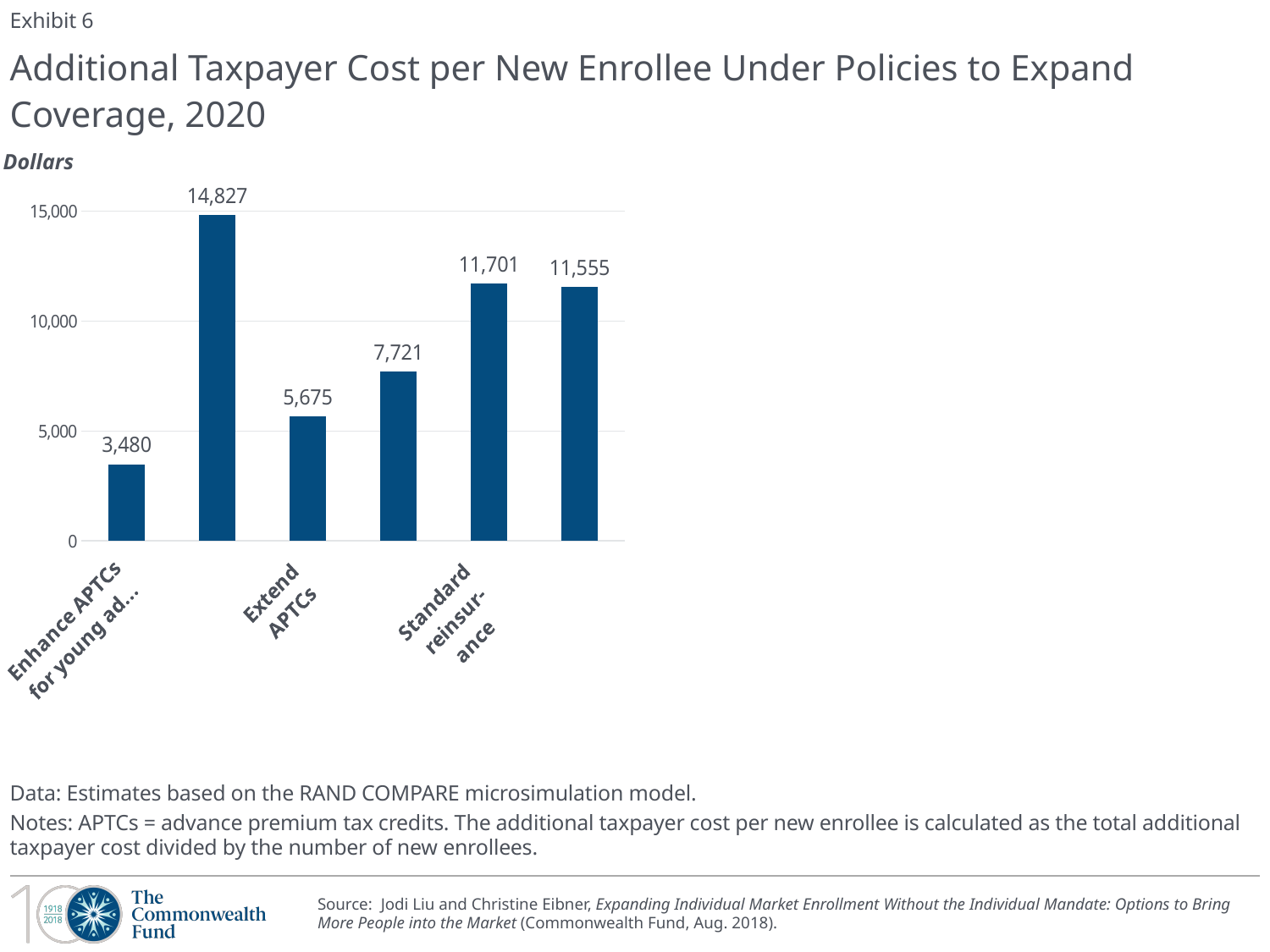
What is the additional taxpayer cost per new enrollee for Extend APTCs? 5,675 Is the value for Standard reinsurance greater or less than 10,000? greater How much larger is the value for Standard reinsurance than the value for Extend APTCs? 6,026 What is the lowest value shown on the chart? 3,480 What is the additional taxpayer cost per new enrollee for Standard reinsurance? 11,701 What kind of chart is shown on the slide? bar chart What unit is indicated for the values on the chart? Dollars What is the difference between the highest and lowest values on the chart? 11,347 Is the value for Extend APTCs greater or less than 10,000? less How many bars are plotted on the chart? 6 What is the highest value shown on the chart? 14,827 Which has a higher additional taxpayer cost per new enrollee, Extend APTCs or Standard reinsurance? Standard reinsurance